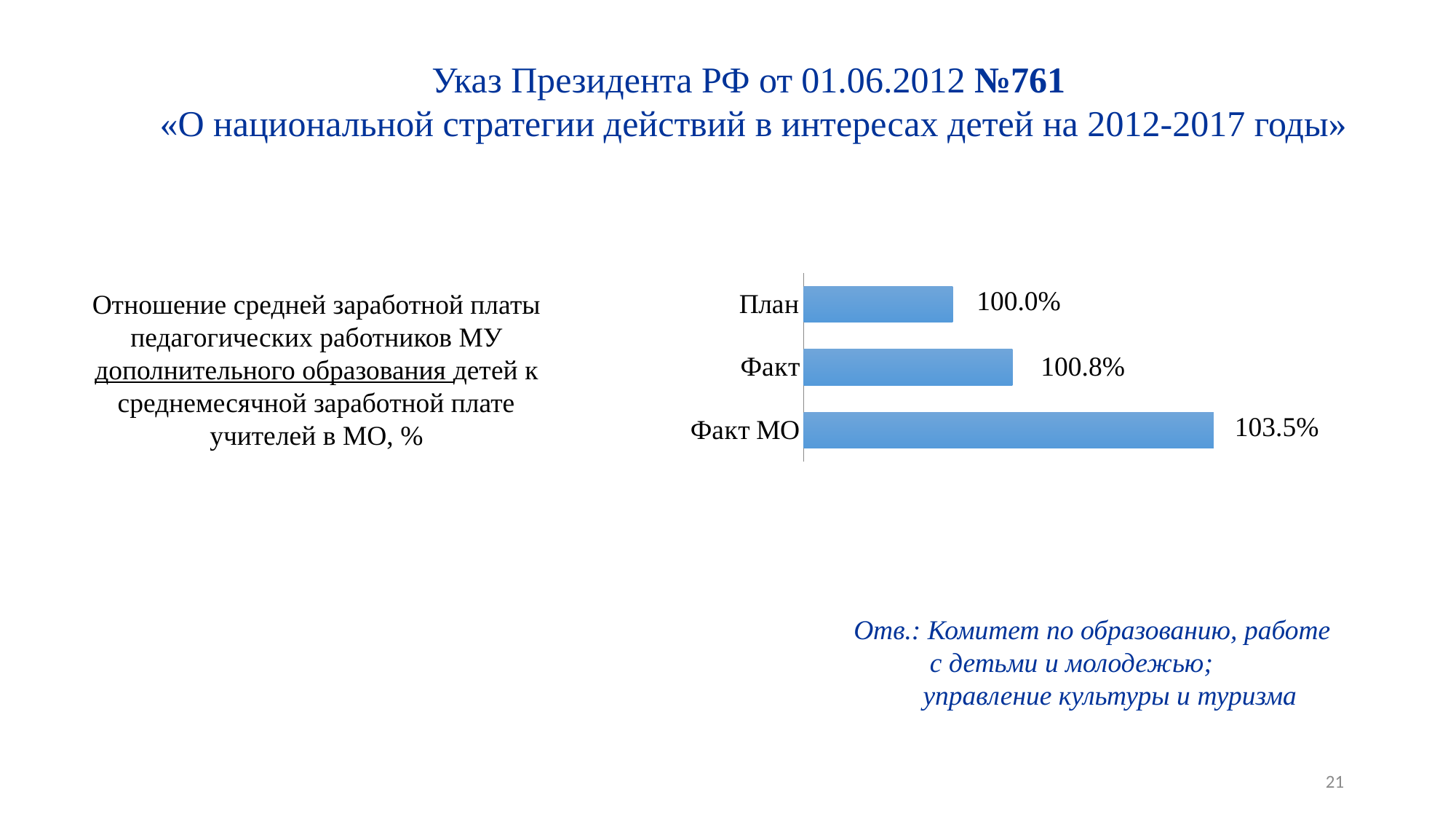
What is the difference between the values for Факт and План? 0.8% Which is larger, the value for Факт МО or the value for Факт? Факт МО Are the bars in the chart horizontal or vertical? Horizontal What colour are the bars in the chart? Blue How many categories are shown in the chart? 3 Which category has the highest value? Факт МО What is the value for Факт? 100.8% Which category has the lowest value? План What is the value for План? 100.0% What kind of chart is shown on the slide? Bar chart What is the value for Факт МО? 103.5% What is the difference between the values for Факт МО and План? 3.5%